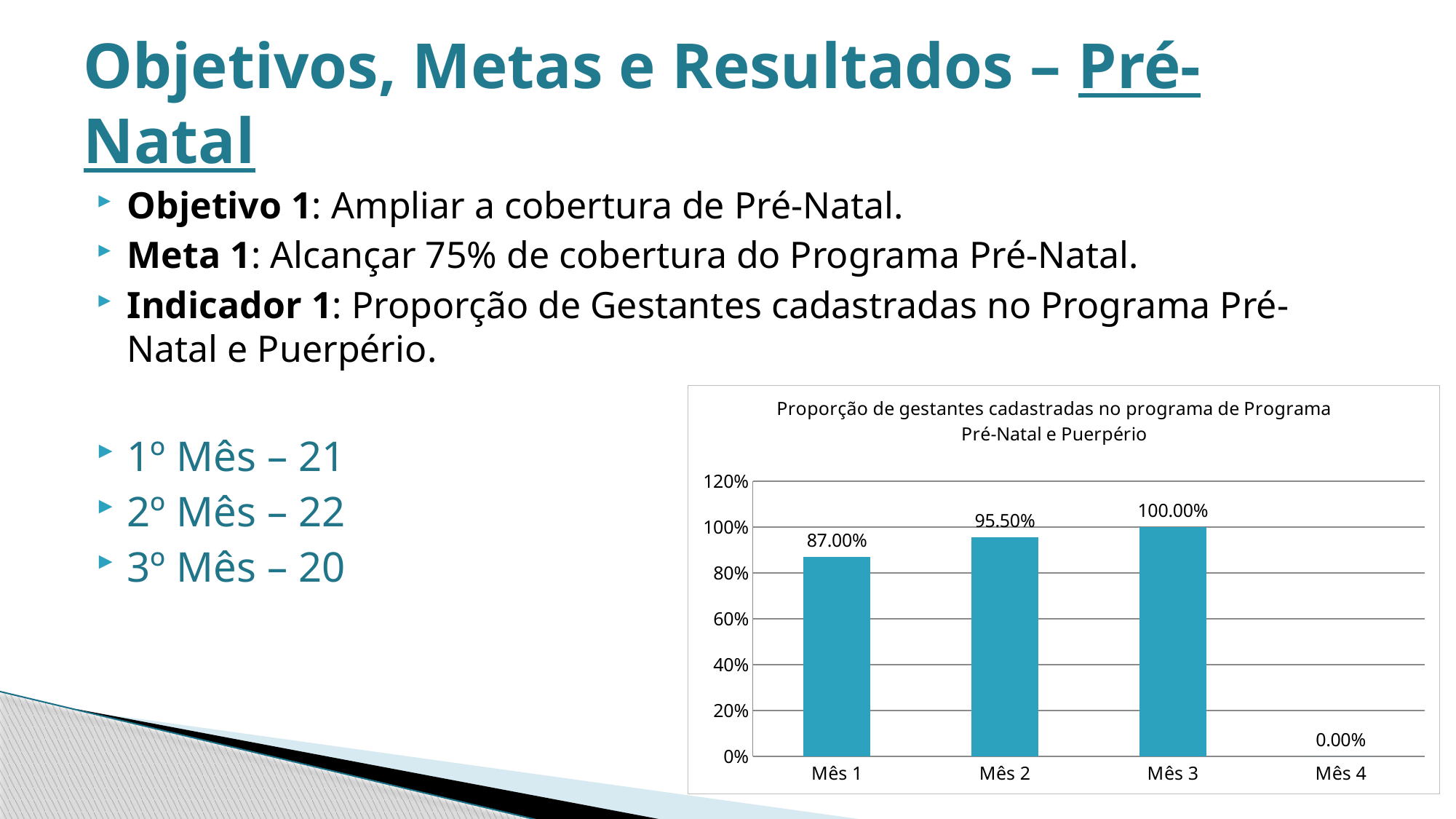
Is the value for Mês 2 greater or less than 80%? greater Which is larger, the value for Mês 2 or the value for Mês 1? Mês 2 What is the value for Mês 3? 100.00% Which category has the highest value? Mês 3 Which category has the lowest value? Mês 4 What kind of chart is shown? bar chart What is the value for Mês 1? 87.00% What is the title of the chart? Proporção de gestantes cadastradas no programa de Programa Pré-Natal e Puerpério What is the value for Mês 2? 95.50% What is the value for Mês 4? 0.00% How many categories are shown on the x axis? 4 What is the difference between the values for Mês 3 and Mês 1? 13.00%